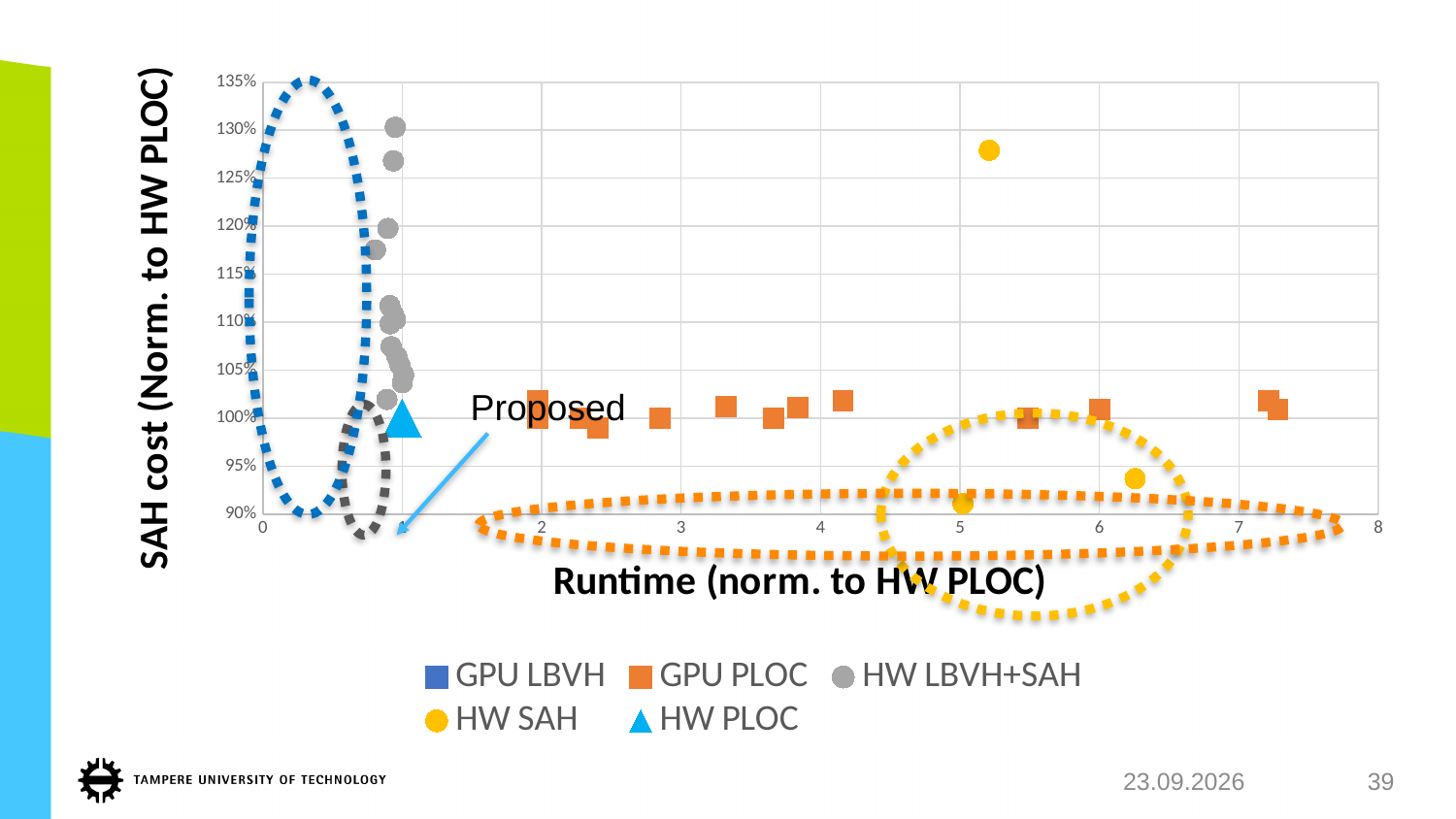
Which series contains the point with the lowest SAH cost? HW SAH What is the SAH cost of the HW PLOC point? 100% Is the runtime of the rightmost GPU PLOC point greater or less than 7? greater What is the title of the horizontal axis? Runtime (norm. to HW PLOC) Which series contains the point with the largest runtime? GPU PLOC How many series does the legend list? 5 What is the title of the vertical axis? SAH cost (Norm. to HW PLOC) Is the SAH cost of the highest HW SAH point greater or less than 125%? greater What is the runtime value of the HW PLOC point? 1 What kind of chart is shown on the slide? scatter chart